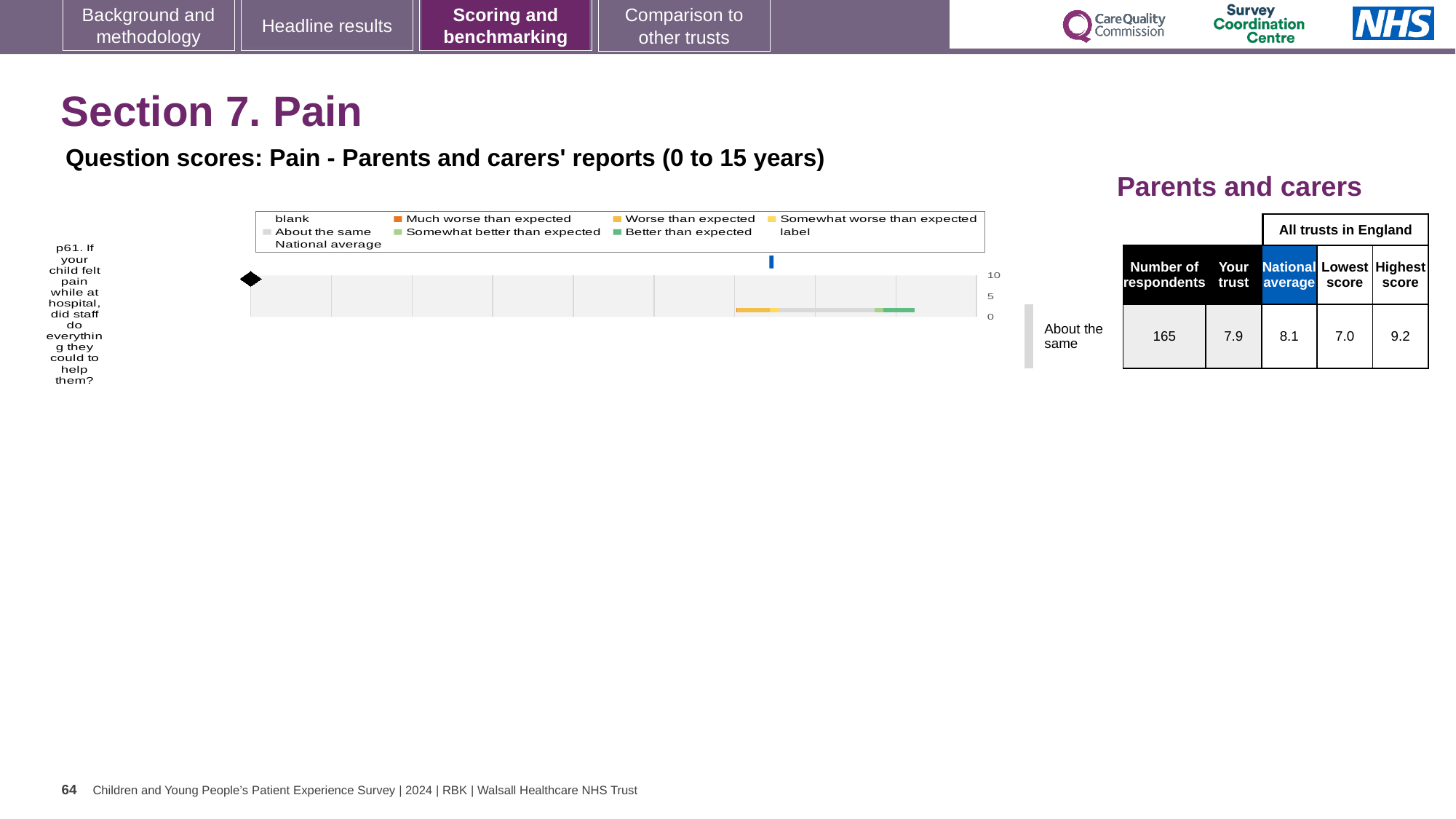
What benchmarking category is the trust's result for question p61 placed in? About the same What is the 'Your trust' score for question p61 (If your child felt pain while at hospital, did staff do everything they could to help them?)? 7.9 What kind of chart is shown on the slide? bar chart Which is larger for question p61: the 'Your trust' score or the national average? National average What is the highest score among all trusts in England for question p61? 9.2 What is the national average score for question p61? 8.1 What is the difference between the highest score (9.2) and the lowest score (7.0) for question p61? 2.2 How many survey questions are plotted in the chart? 1 How many respondents answered question p61? 165 Is the 'Your trust' score for question p61 greater or less than 5 on the chart's axis? greater Which colour in the chart legend represents 'Better than expected'? Green What is the lowest score among all trusts in England for question p61? 7.0